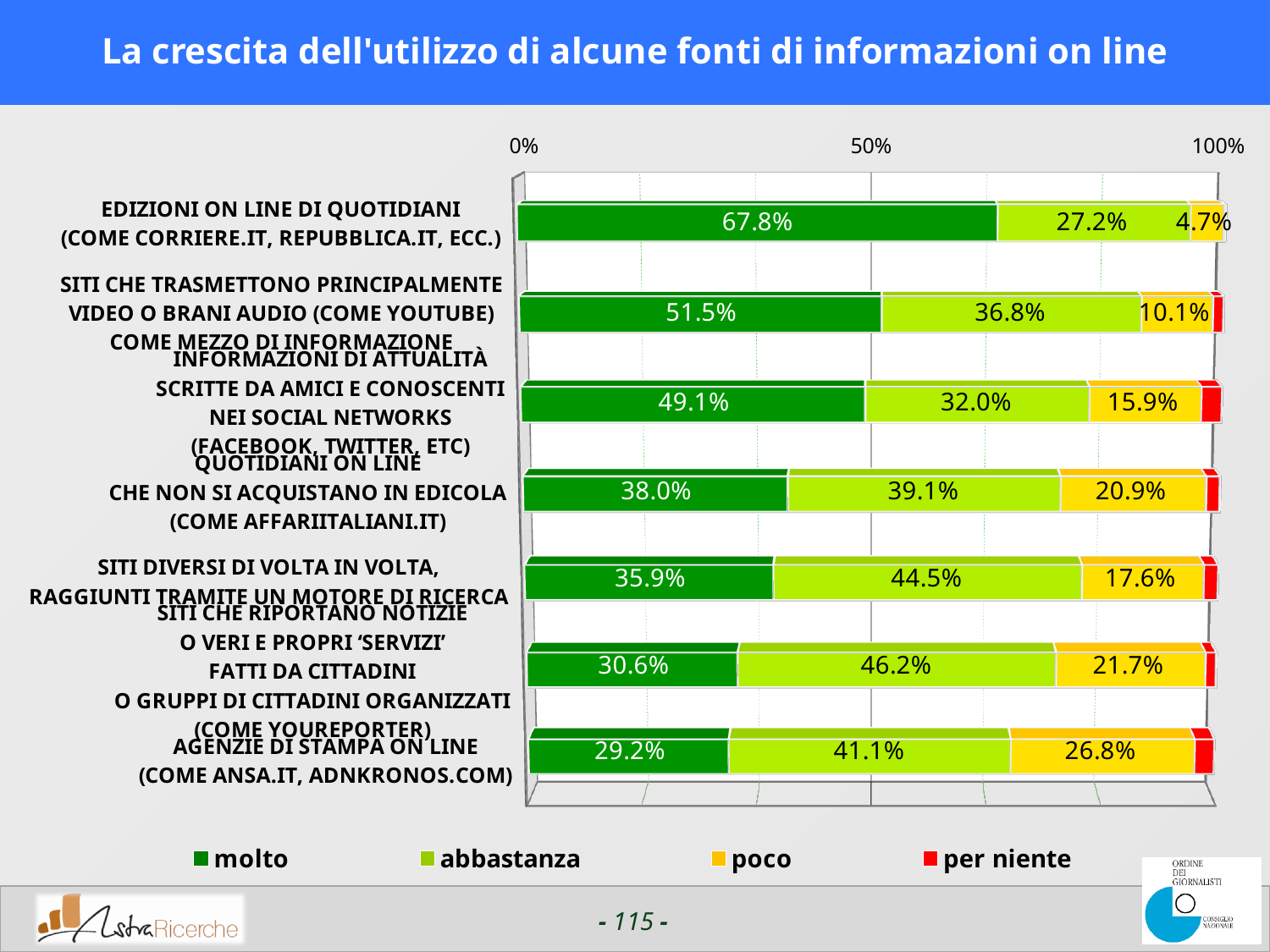
How many series does the legend list? 4 What is the 'poco' value for 'Siti che trasmettono principalmente video o brani audio (come YouTube)'? 10.1% How many categories (information sources) are plotted in the chart? 7 What is the 'abbastanza' value for 'Agenzie di stampa on line (come ANSA.it, Adnkronos.com)'? 41.1% What is the difference between the 'molto' values for 'Edizioni on line di quotidiani' and 'Siti che trasmettono principalmente video o brani audio (come YouTube)'? 16.3% Which category has the lowest 'molto' value? Agenzie di stampa on line (come ANSA.it, Adnkronos.com) What colour represents the 'per niente' series in the legend? red Which category has the highest 'poco' value? Agenzie di stampa on line (come ANSA.it, Adnkronos.com) What type of chart is shown on the slide? stacked bar chart What is the 'molto' value for 'Edizioni on line di quotidiani (come Corriere.it, Repubblica.it, ecc.)'? 67.8% Which category has the highest 'molto' value? Edizioni on line di quotidiani (come Corriere.it, Repubblica.it, ecc.) Which is larger for 'Quotidiani on line che non si acquistano in edicola': the 'molto' value or the 'abbastanza' value? abbastanza